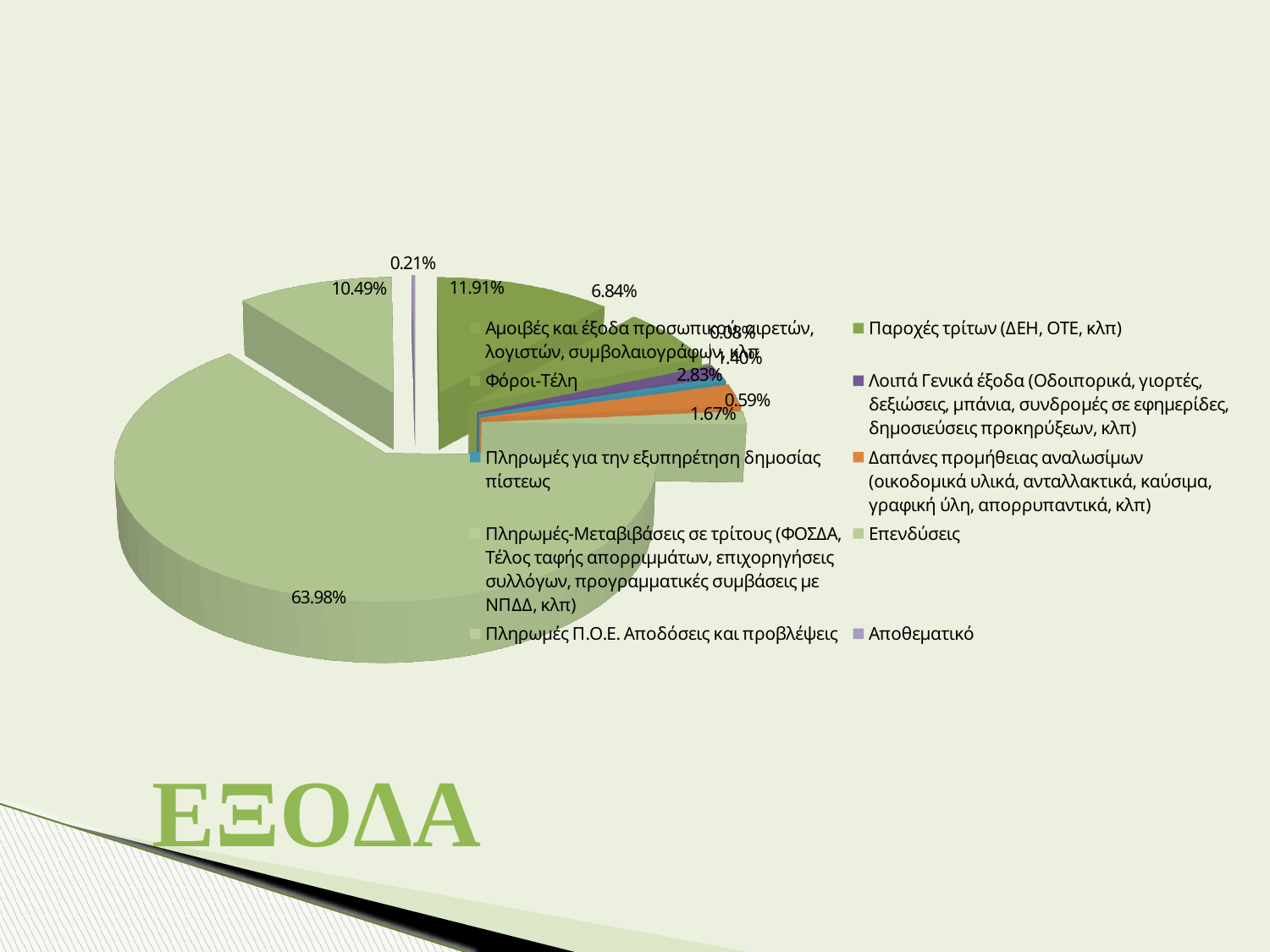
How many slices in the pie chart have a share below 1%? 3 What is the combined share of the 10.49% and 11.91% slices in the pie chart? 22.40% What is the title shown on the slide for the chart? ΕΞΟΔΑ Is the largest slice of the pie chart greater or less than 50%? greater What is the difference between the 2.83% slice and the 1.67% slice in the pie chart? 1.16% How many categories does the legend of the pie chart list? 10 What is the difference between the largest slice (63.98%) and the second-largest slice (11.91%) in the pie chart? 52.07% Which is larger in the pie chart: the 6.84% slice or the 10.49% slice? 10.49% What kind of chart is shown on the slide? pie chart What is the share of the smallest slice in the pie chart? 0.08% What is the share of the largest slice in the pie chart? 63.98%